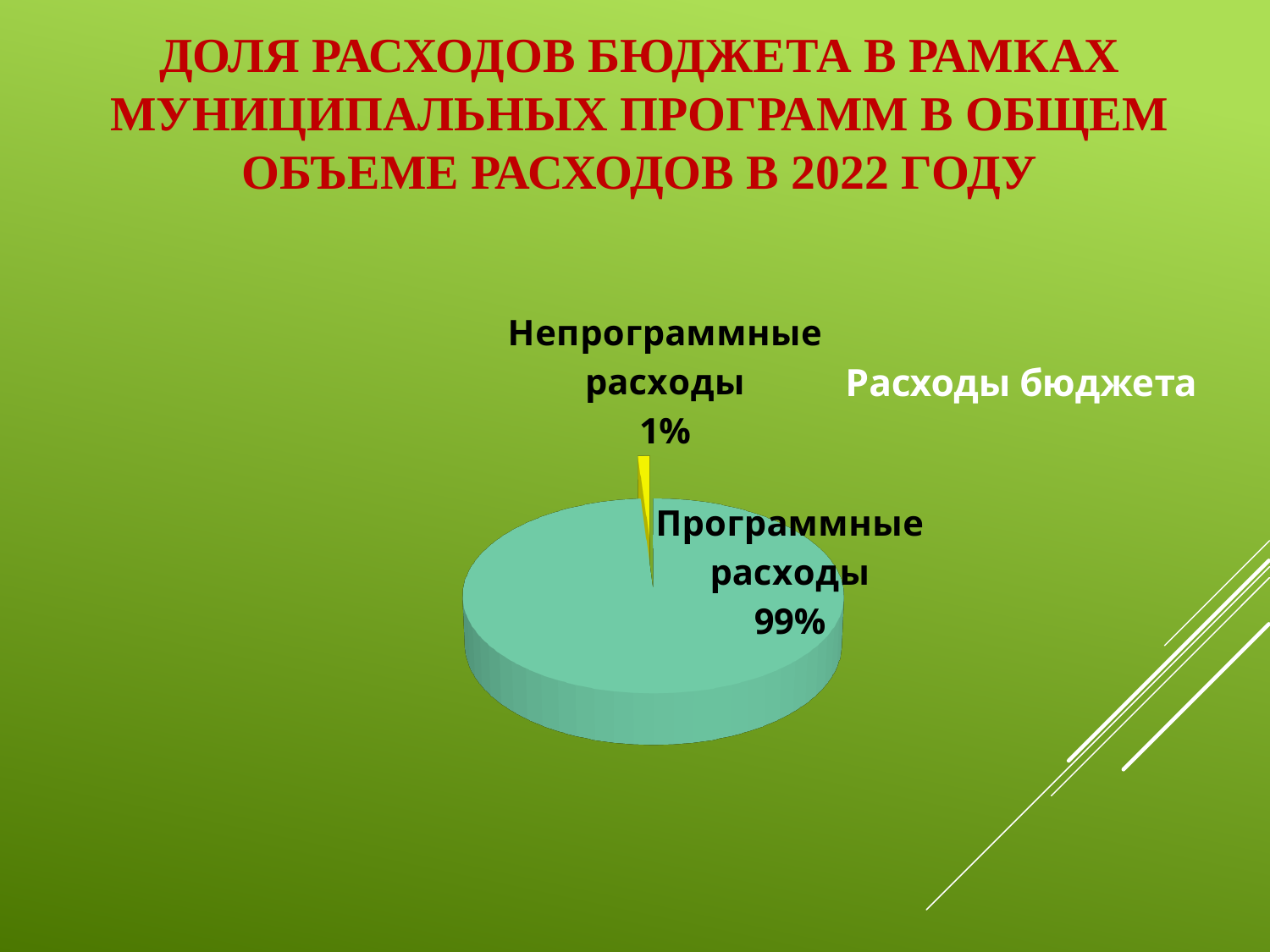
What is the difference in percentage points between "Программные расходы" and "Непрограммные расходы"? 98 Which is larger: "Программные расходы" or "Непрограммные расходы"? Программные расходы What colour is the "Непрограммные расходы" slice? yellow What share of the pie is labelled "Программные расходы"? 99% How many slices does the pie chart have? 2 What kind of chart is shown on the slide? pie chart Which slice of the pie is the largest? Программные расходы What is the title of the pie chart? Расходы бюджета What share of the pie is labelled "Непрограммные расходы"? 1% Which slice of the pie is the smallest? Непрограммные расходы